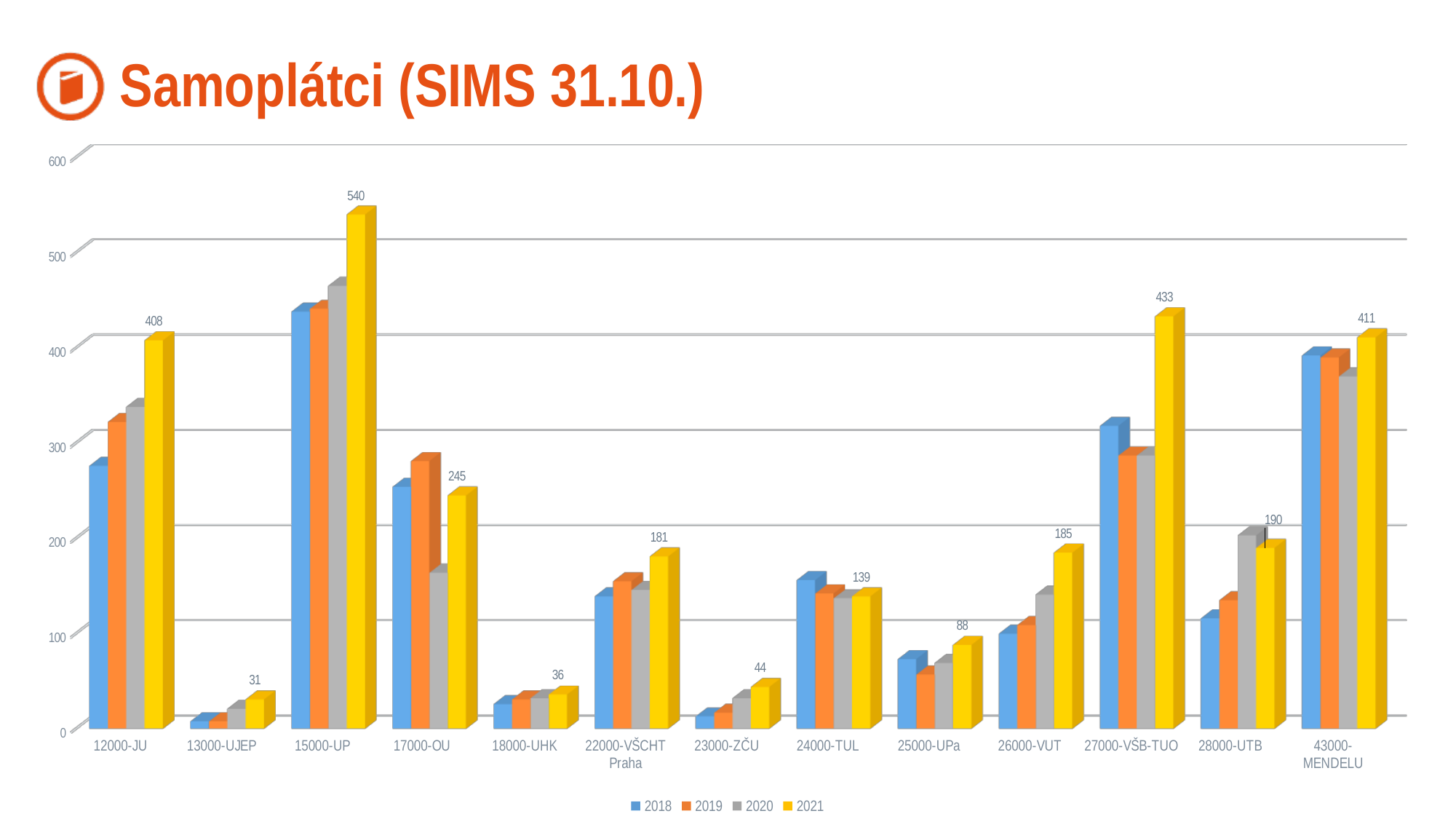
What kind of chart is shown on the slide? bar chart How many series does the legend list? 4 Which has the larger 2021 value, 26000-VUT or 28000-UTB? 28000-UTB Is the 2018 value for 15000-UP greater or less than 400? greater How many categories are shown on the x axis? 13 Is the 2020 value for 17000-OU greater or less than 200? less Which category has the lowest 2021 value? 13000-UJEP What is the 2021 value for 27000-VŠB-TUO? 433 What is the 2021 value for 13000-UJEP? 31 What is the 2021 value for 15000-UP? 540 What is the difference between the 2021 values for 15000-UP and 27000-VŠB-TUO? 107 Which category has the highest 2021 value? 15000-UP